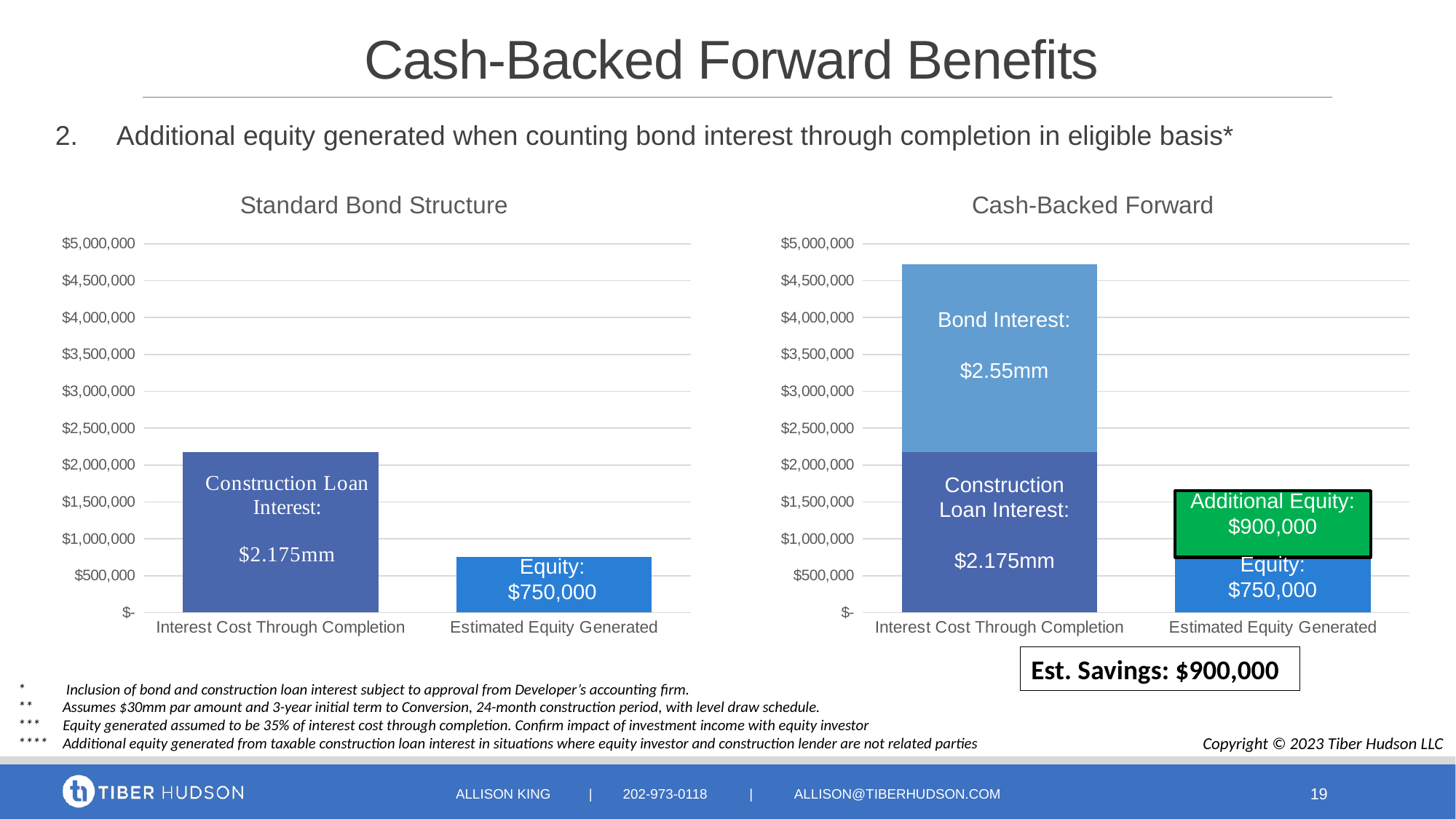
How many categories are shown on the x axis of the Cash-Backed Forward chart? 2 What kind of chart is the Standard Bond Structure chart? Bar chart In the Standard Bond Structure chart, what is the Construction Loan Interest value shown on the Interest Cost Through Completion bar? $2.175mm In the Cash-Backed Forward chart, what is the Additional Equity value shown for Estimated Equity Generated? $900,000 In the Cash-Backed Forward chart, what is the total of the Estimated Equity Generated stacked bar (Equity plus Additional Equity)? $1,650,000 In the Cash-Backed Forward chart, is the Interest Cost Through Completion bar greater or less than $4,500,000? greater In the Standard Bond Structure chart, is the Interest Cost Through Completion bar greater or less than $2,000,000? greater In the Cash-Backed Forward chart, what is the total of the Interest Cost Through Completion stacked bar (Construction Loan Interest plus Bond Interest)? $4.725mm In the Standard Bond Structure chart, what is the Equity value shown for Estimated Equity Generated? $750,000 In the Cash-Backed Forward chart, what is the Bond Interest value shown on the Interest Cost Through Completion bar? $2.55mm In the Cash-Backed Forward chart, what is the difference between the Additional Equity and the Equity values in the Estimated Equity Generated bar? $150,000 In the Standard Bond Structure chart, which category has the higher bar, Interest Cost Through Completion or Estimated Equity Generated? Interest Cost Through Completion